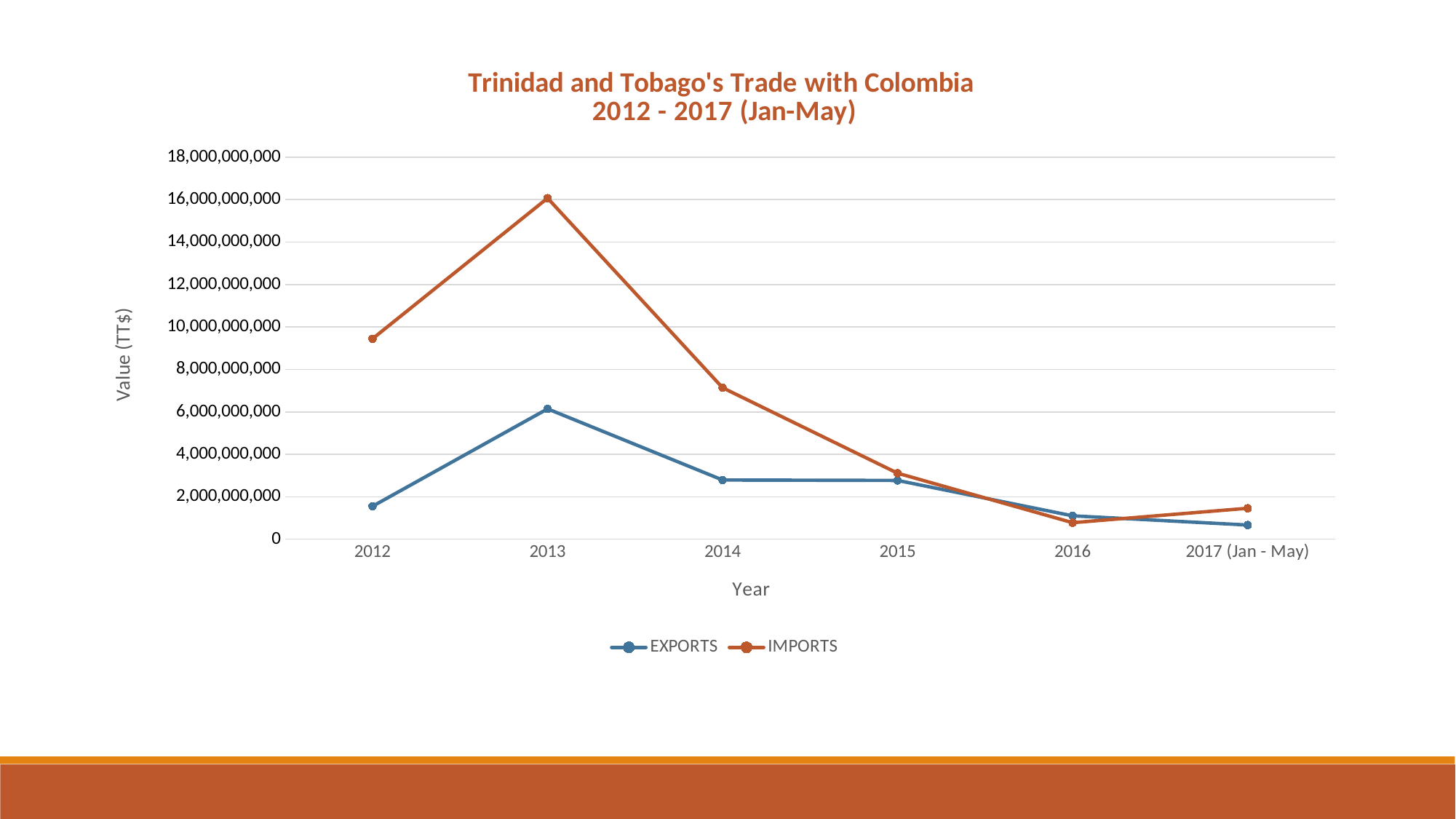
In 2014, which was larger, EXPORTS or IMPORTS? IMPORTS What kind of chart is shown on the slide? line chart In which period were EXPORTS lowest? 2017 (Jan - May) In which year were IMPORTS highest? 2013 How many years (points) are plotted along the x axis? 6 How many series does the legend list? 2 Is the value for IMPORTS in 2012 greater or less than 8,000,000,000? greater In which year were EXPORTS highest? 2013 In which year were IMPORTS lowest? 2016 Is the value for EXPORTS in 2012 greater or less than 2,000,000,000? less Is the value for IMPORTS in 2013 greater or less than 14,000,000,000? greater Do IMPORTS rise or fall from 2013 to 2016? fall